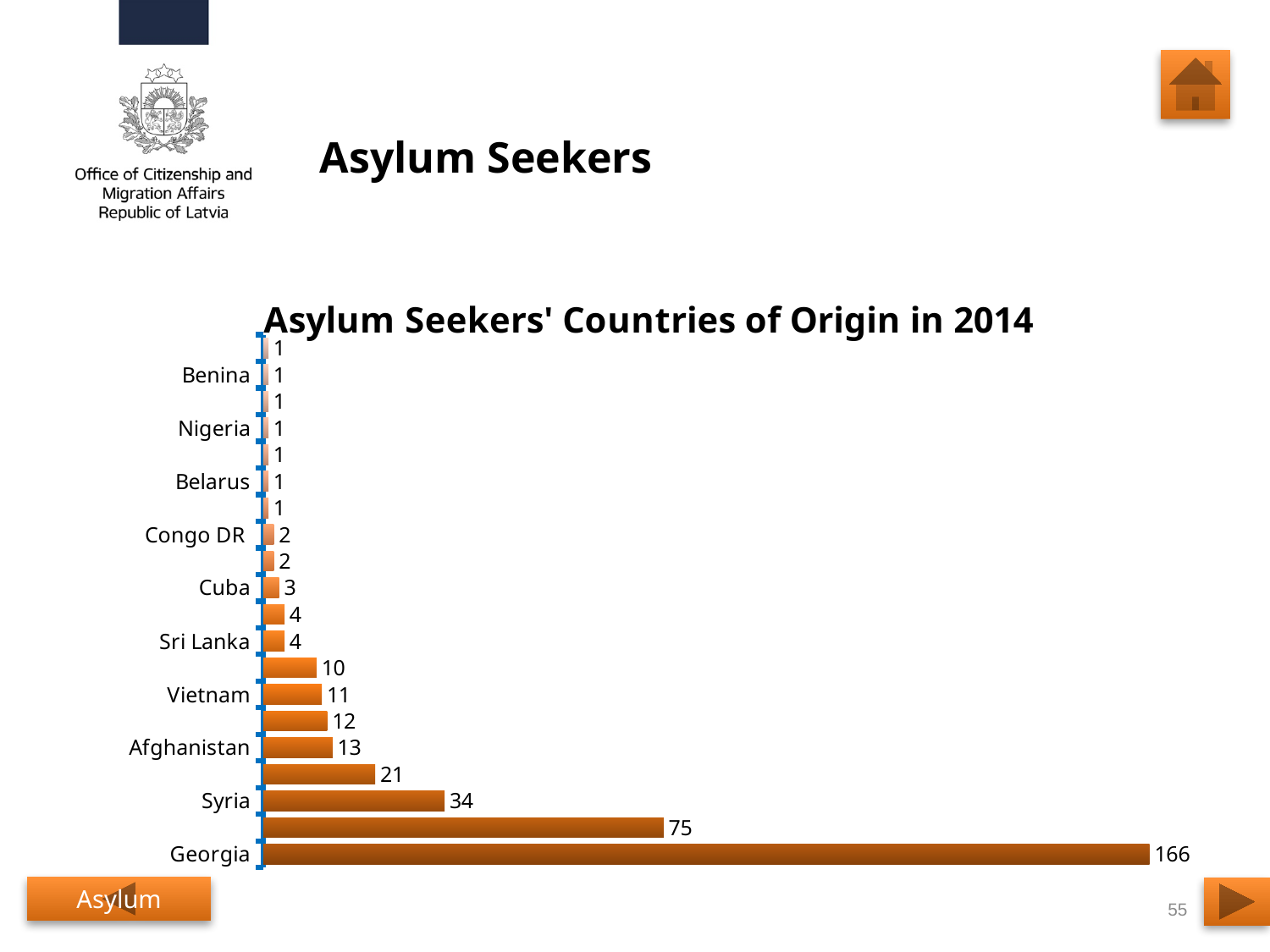
What is the difference between the values for Georgia and Syria? 132 How many bars are plotted in the chart? 20 What is the value for Syria? 34 What is the value for Vietnam? 11 What is the value for Georgia in the Asylum Seekers' Countries of Origin in 2014 chart? 166 What is the value for Sri Lanka? 4 Which country has the highest value in the chart? Georgia Which is larger, the value for Syria or the value for Afghanistan? Syria What type of chart is shown on the slide? Bar chart What is the value for Cuba? 3 What is the value for Congo DR? 2 What is the value for Afghanistan? 13